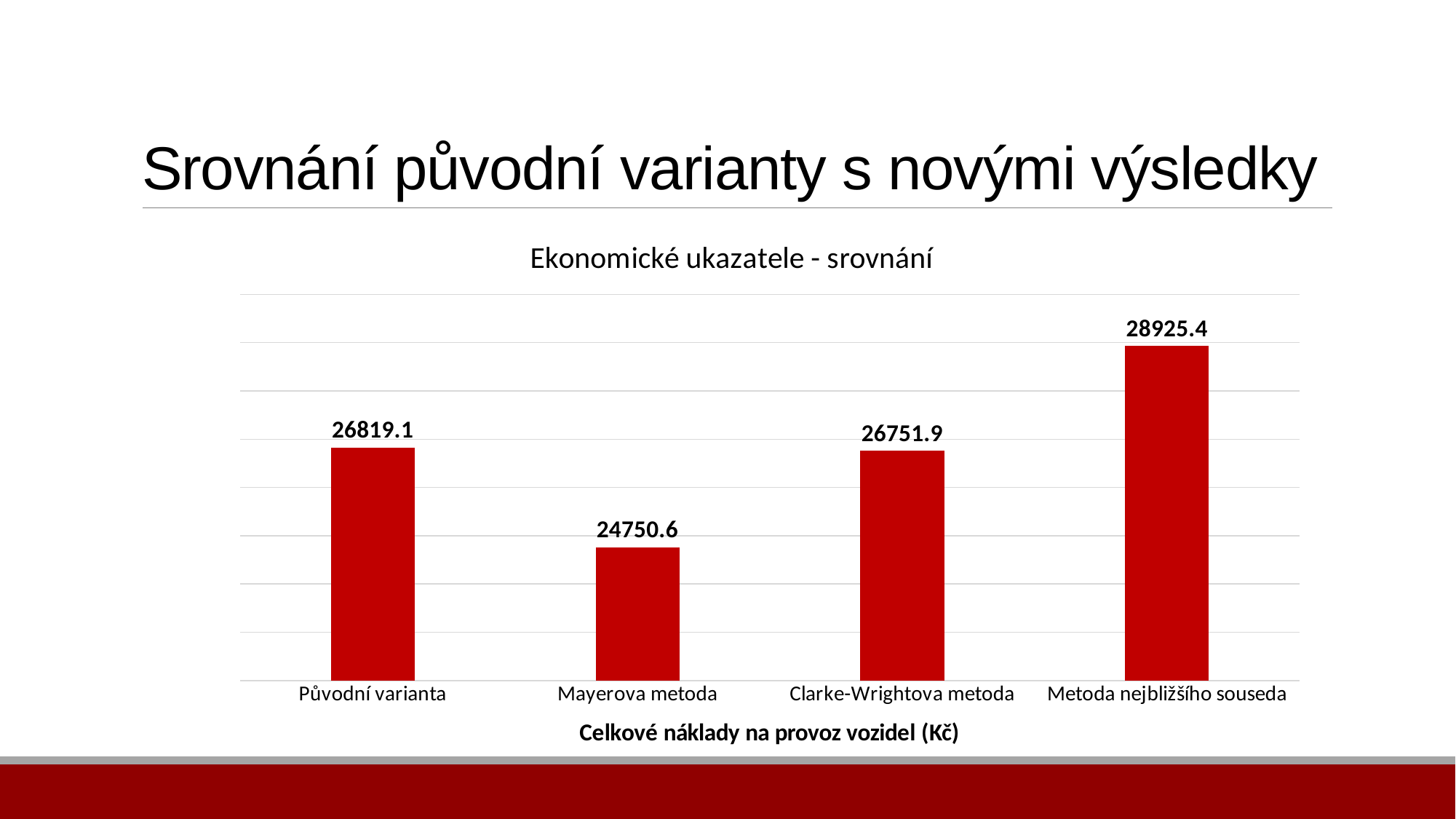
What is the title of the chart? Ekonomické ukazatele - srovnání What is the value for Původní varianta? 26819.1 What is the value for Clarke-Wrightova metoda? 26751.9 Which category has the lowest value? Mayerova metoda What is the difference between the values for Metoda nejbližšího souseda and Mayerova metoda? 4174.8 What is the difference between the values for Původní varianta and Clarke-Wrightova metoda? 67.2 Which is larger, the value for Původní varianta or the value for Mayerova metoda? Původní varianta How many categories are shown on the x axis? 4 What is the value for Mayerova metoda? 24750.6 What kind of chart is shown on the slide? Bar chart What is the value for Metoda nejbližšího souseda? 28925.4 Which category has the highest value? Metoda nejbližšího souseda